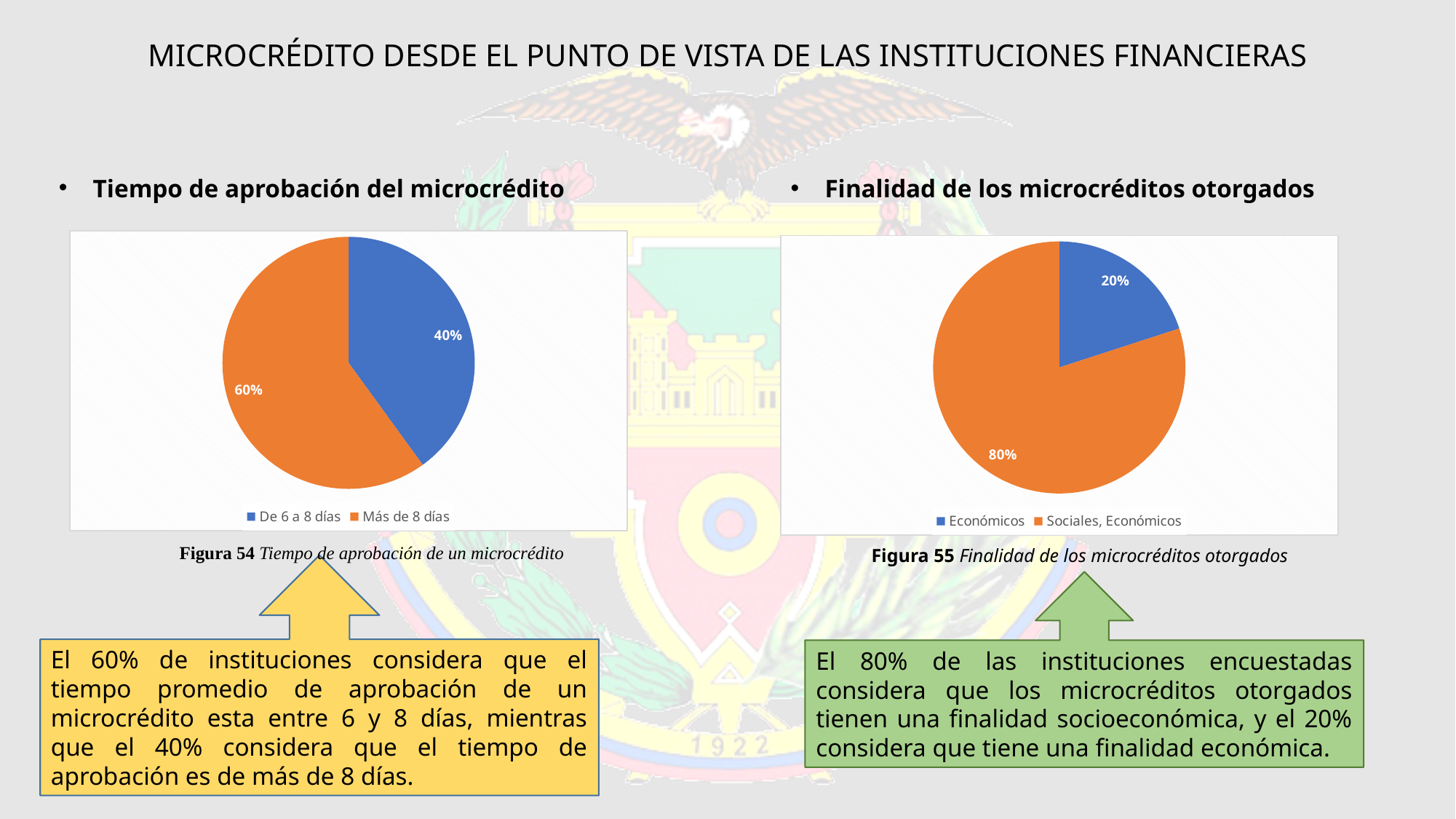
In the left pie chart (Tiempo de aprobación del microcrédito), which category has the largest slice? Más de 8 días What type of chart is the left chart (Tiempo de aprobación del microcrédito)? Pie chart In the right pie chart (Finalidad de los microcréditos otorgados), which is larger: 'Económicos' or 'Sociales, Económicos'? Sociales, Económicos In the left pie chart (Tiempo de aprobación del microcrédito), what share is labelled for 'Más de 8 días'? 60% In the left pie chart (Tiempo de aprobación del microcrédito), what is the difference between the 'Más de 8 días' and 'De 6 a 8 días' shares? 20% In the left pie chart (Tiempo de aprobación del microcrédito), how many slices does the pie have? 2 In the left pie chart (Tiempo de aprobación del microcrédito), what share is labelled for 'De 6 a 8 días'? 40% In the right pie chart (Finalidad de los microcréditos otorgados), what share is labelled for 'Económicos'? 20% In the right pie chart (Finalidad de los microcréditos otorgados), what share is labelled for 'Sociales, Económicos'? 80% In the right pie chart (Finalidad de los microcréditos otorgados), which category has the smallest slice? Económicos In the right pie chart (Finalidad de los microcréditos otorgados), what colour is the 'Económicos' slice? Blue In the right pie chart (Finalidad de los microcréditos otorgados), what is the difference between the 'Sociales, Económicos' and 'Económicos' shares? 60%